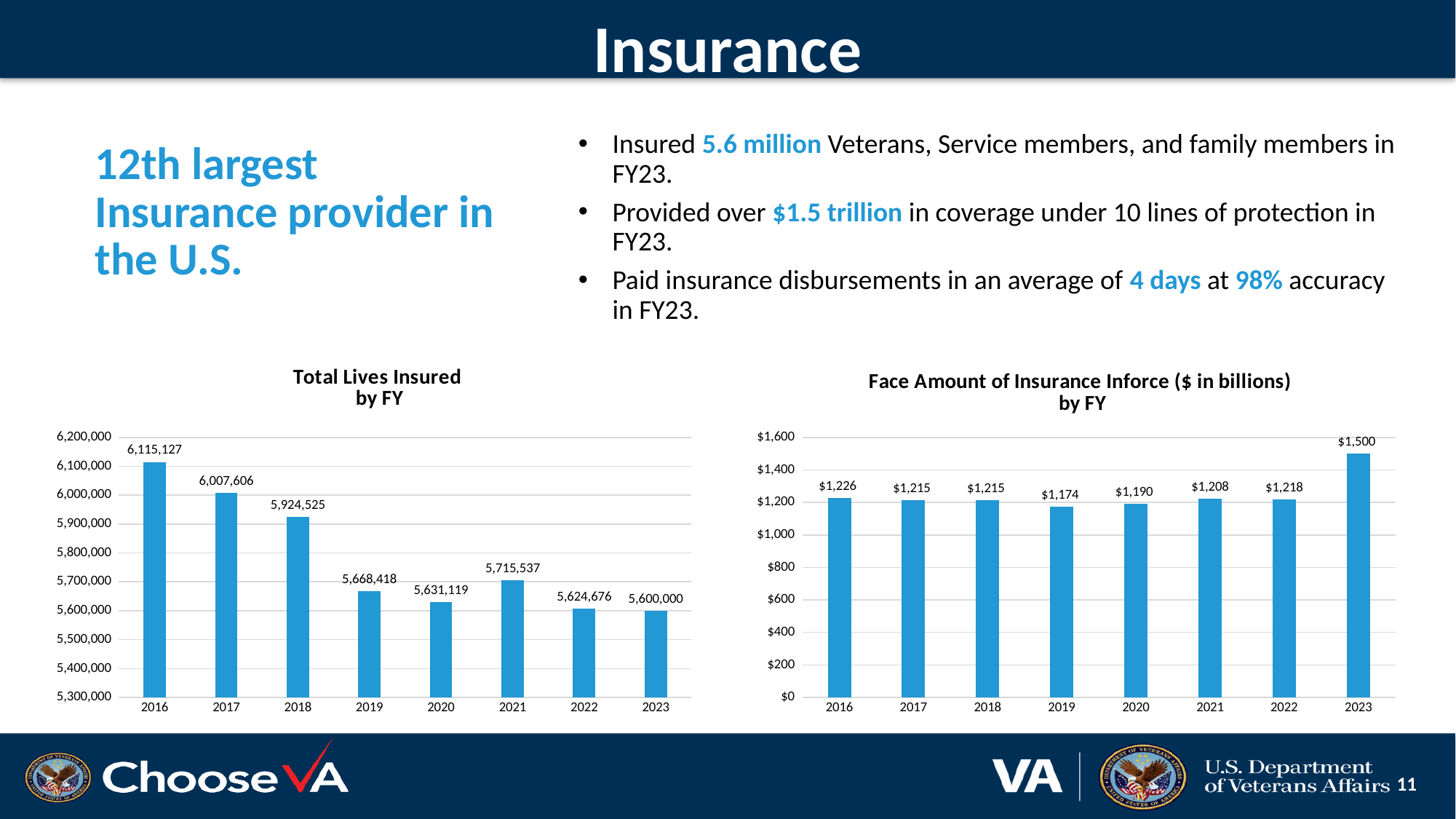
In the 'Total Lives Insured by FY' chart, do the values generally rise or fall from 2016 to 2023? Fall In the 'Total Lives Insured by FY' chart, which is larger, the value for 2020 or the value for 2021? 2021 In the 'Total Lives Insured by FY' chart, what is the difference between the 2016 and 2017 values? 107,521 In the 'Face Amount of Insurance Inforce ($ in billions) by FY' chart, which year has the highest value? 2023 In the 'Face Amount of Insurance Inforce ($ in billions) by FY' chart, what is the value for 2023? $1,500 What kind of chart is 'Total Lives Insured by FY'? Bar chart In the 'Total Lives Insured by FY' chart, which year has the lowest value? 2023 In the 'Total Lives Insured by FY' chart, how many years are shown on the x axis? 8 In the 'Face Amount of Insurance Inforce ($ in billions) by FY' chart, what is the value for 2019? $1,174 In the 'Face Amount of Insurance Inforce ($ in billions) by FY' chart, which year has the lowest value? 2019 In the 'Face Amount of Insurance Inforce ($ in billions) by FY' chart, what is the difference between the 2023 and 2022 values? $282 In the 'Total Lives Insured by FY' chart, what is the value for 2016? 6,115,127